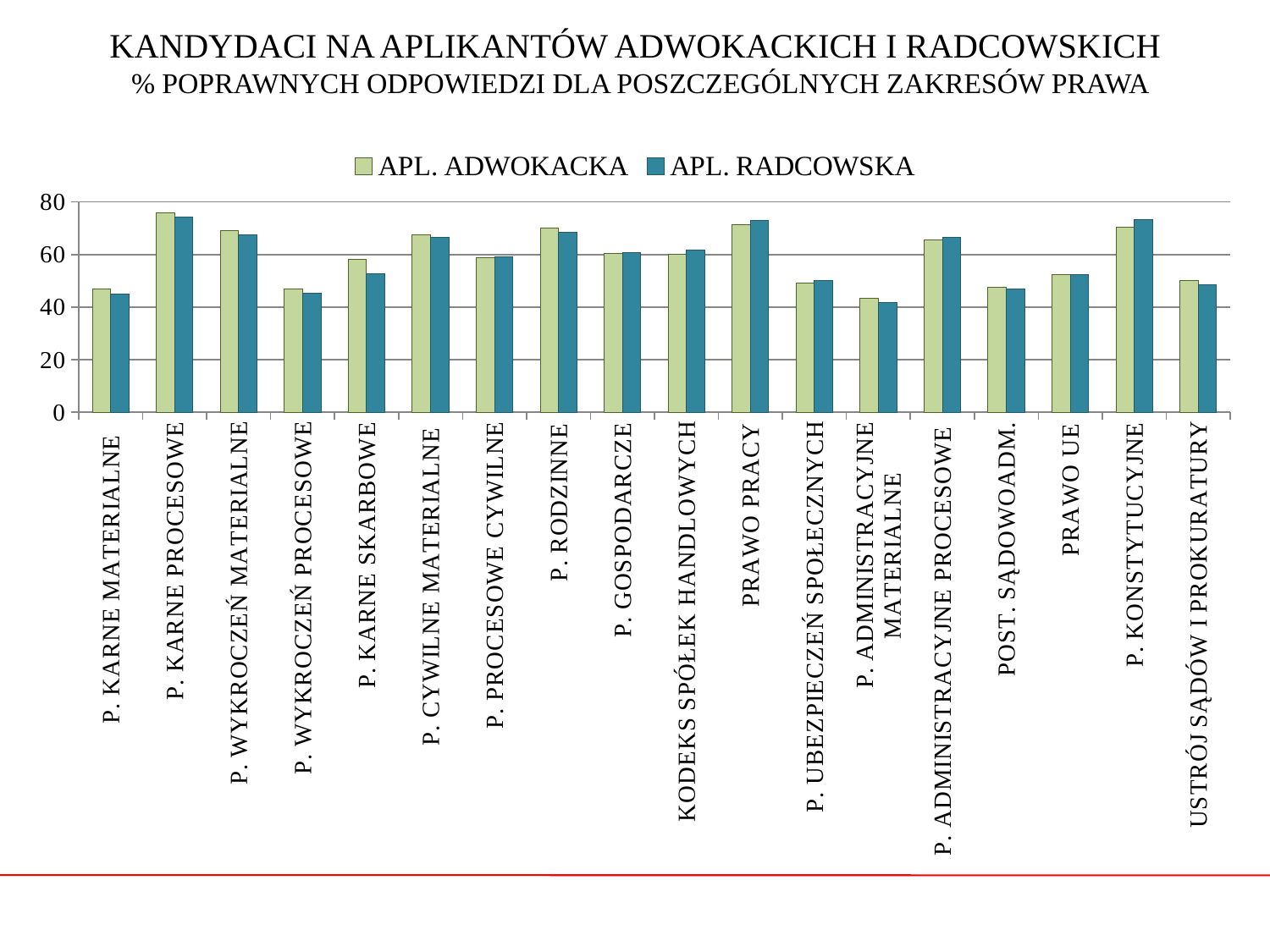
How many categories (areas of law) are shown on the x axis? 18 Which category has the lowest value for APL. RADCOWSKA? P. ADMINISTRACYJNE MATERIALNE Is the APL. ADWOKACKA value for P. KARNE PROCESOWE greater or less than 60? greater What are the two series named in the legend? APL. ADWOKACKA and APL. RADCOWSKA For P. KARNE SKARBOWE, which series has the larger value, APL. ADWOKACKA or APL. RADCOWSKA? APL. ADWOKACKA Is the APL. RADCOWSKA value for P. ADMINISTRACYJNE MATERIALNE greater or less than 60? less Is the APL. ADWOKACKA value for P. KARNE SKARBOWE greater or less than 40? greater What kind of chart is shown on the slide? bar chart Which category has the lowest value for APL. ADWOKACKA? P. ADMINISTRACYJNE MATERIALNE Which category has the highest value for APL. ADWOKACKA? P. KARNE PROCESOWE How many series does the legend list? 2